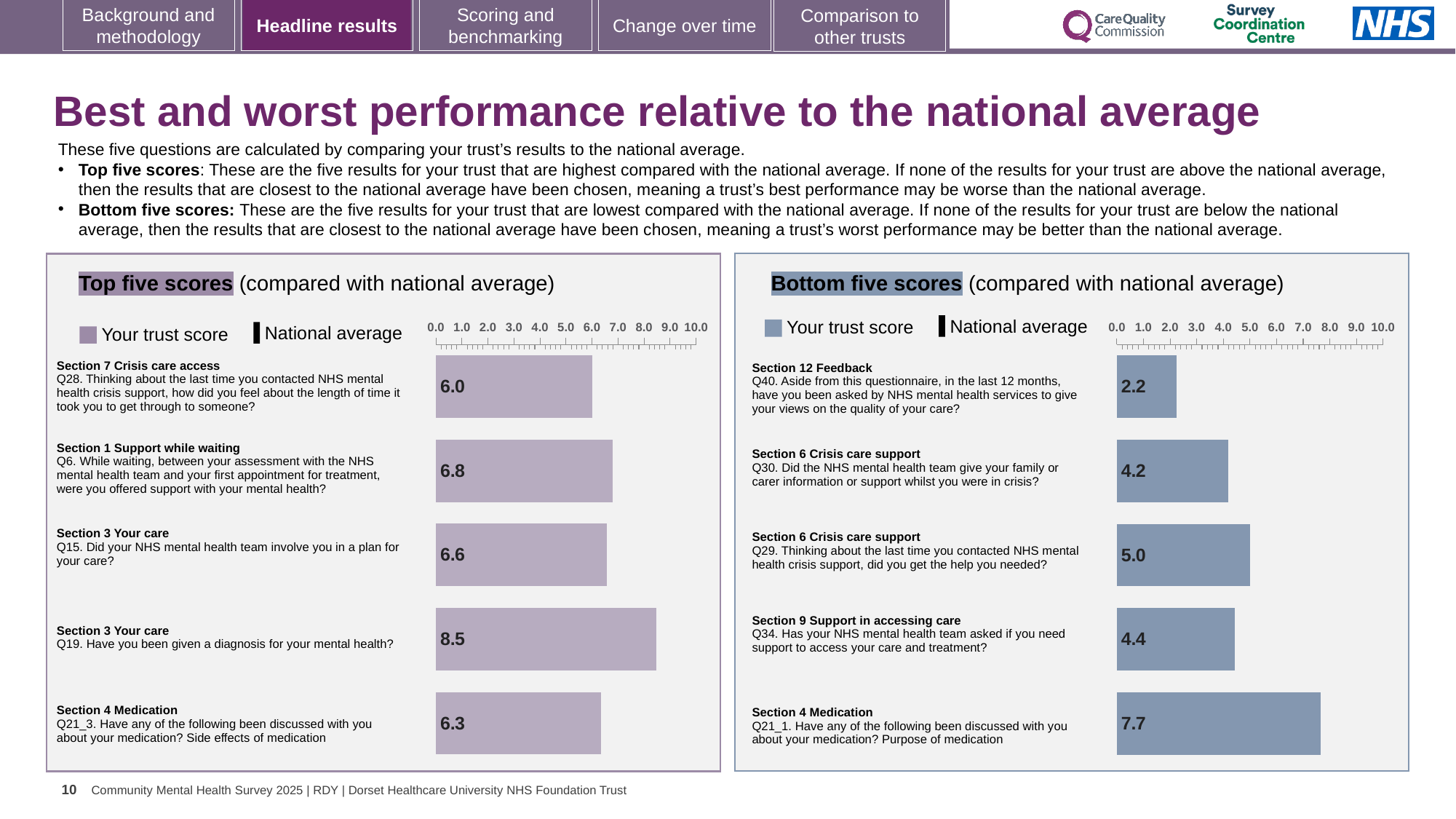
In the Bottom five scores chart, what is the trust score for Q40 (Section 12 Feedback)? 2.2 In the Top five scores chart, what is the difference between the trust scores for Q19 and Q28? 2.5 In the Top five scores chart, which question has the highest trust score? Q19 How many series does the legend of the Top five scores chart list? 2 In the Bottom five scores chart, what is the trust score for Q21_1 on the purpose of medication? 7.7 In the Top five scores chart, what is the trust score for Q19 (Have you been given a diagnosis for your mental health?)? 8.5 In the Bottom five scores chart, which question has the lowest trust score? Q40 In the Bottom five scores chart, what is the difference between the trust scores for Q21_1 and Q40? 5.5 In the Bottom five scores chart, which has the larger trust score, Q30 or Q34? Q34 In the Top five scores chart, what is the trust score for Q28 on crisis care access? 6.0 What type of chart is the Top five scores chart? Bar chart How many questions are plotted in the Bottom five scores chart? 5